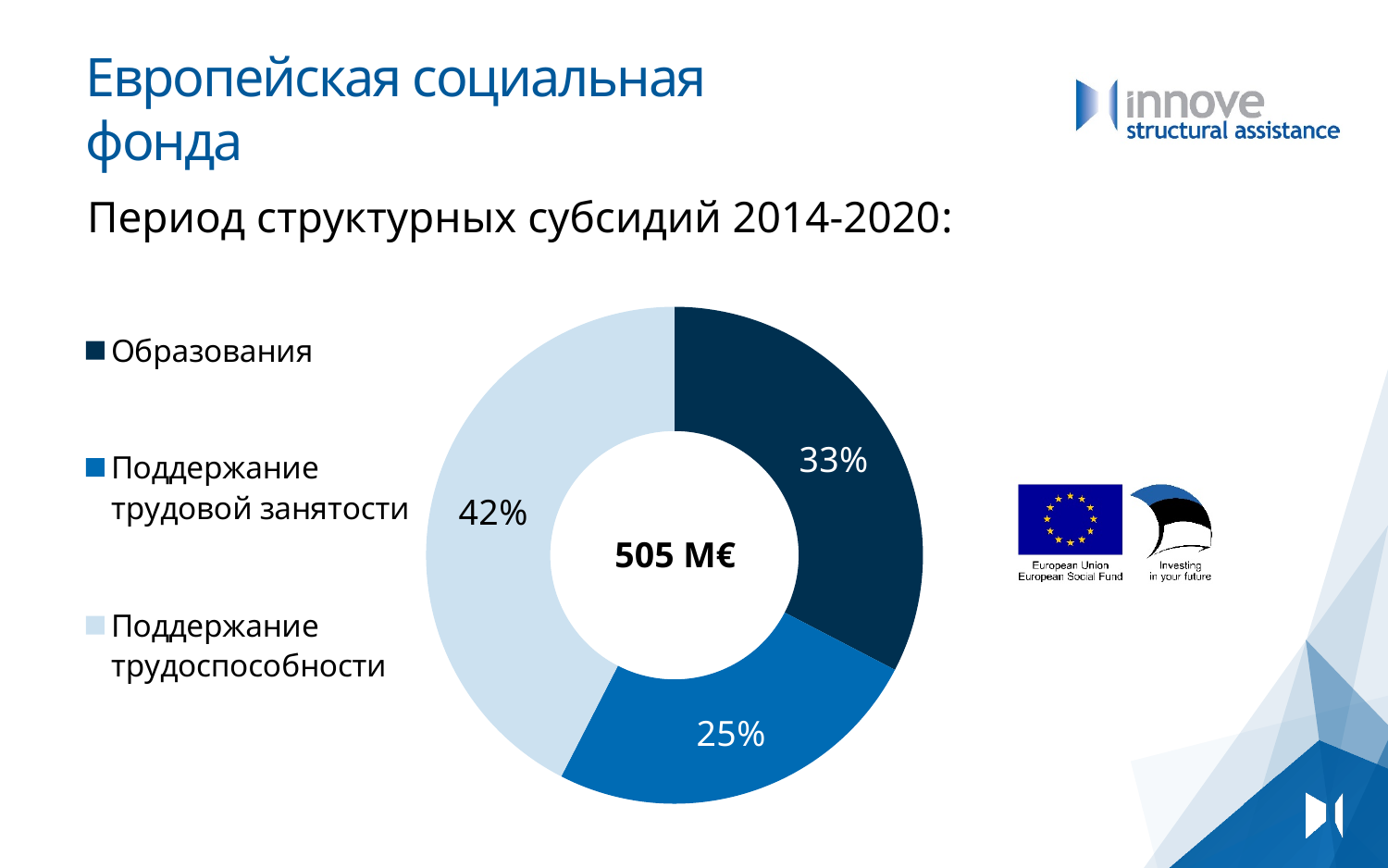
What share of the pie chart does Поддержание трудовой занятости represent? 25% What share of the pie chart does Образования represent? 33% Which has a larger share, Образования or Поддержание трудовой занятости? Образования Which category is shown in the darkest blue colour in the pie chart? Образования Which category has the smallest share of the pie chart? Поддержание трудовой занятости What share of the pie chart does Поддержание трудоспособности represent? 42% What kind of chart is shown on the slide? Doughnut chart Which category has the largest share of the pie chart? Поддержание трудоспособности How many categories are shown in the pie chart? 3 What is the difference in percentage points between the shares of Поддержание трудоспособности and Образования? 9 What total amount is printed in the centre of the pie chart? 505 M€